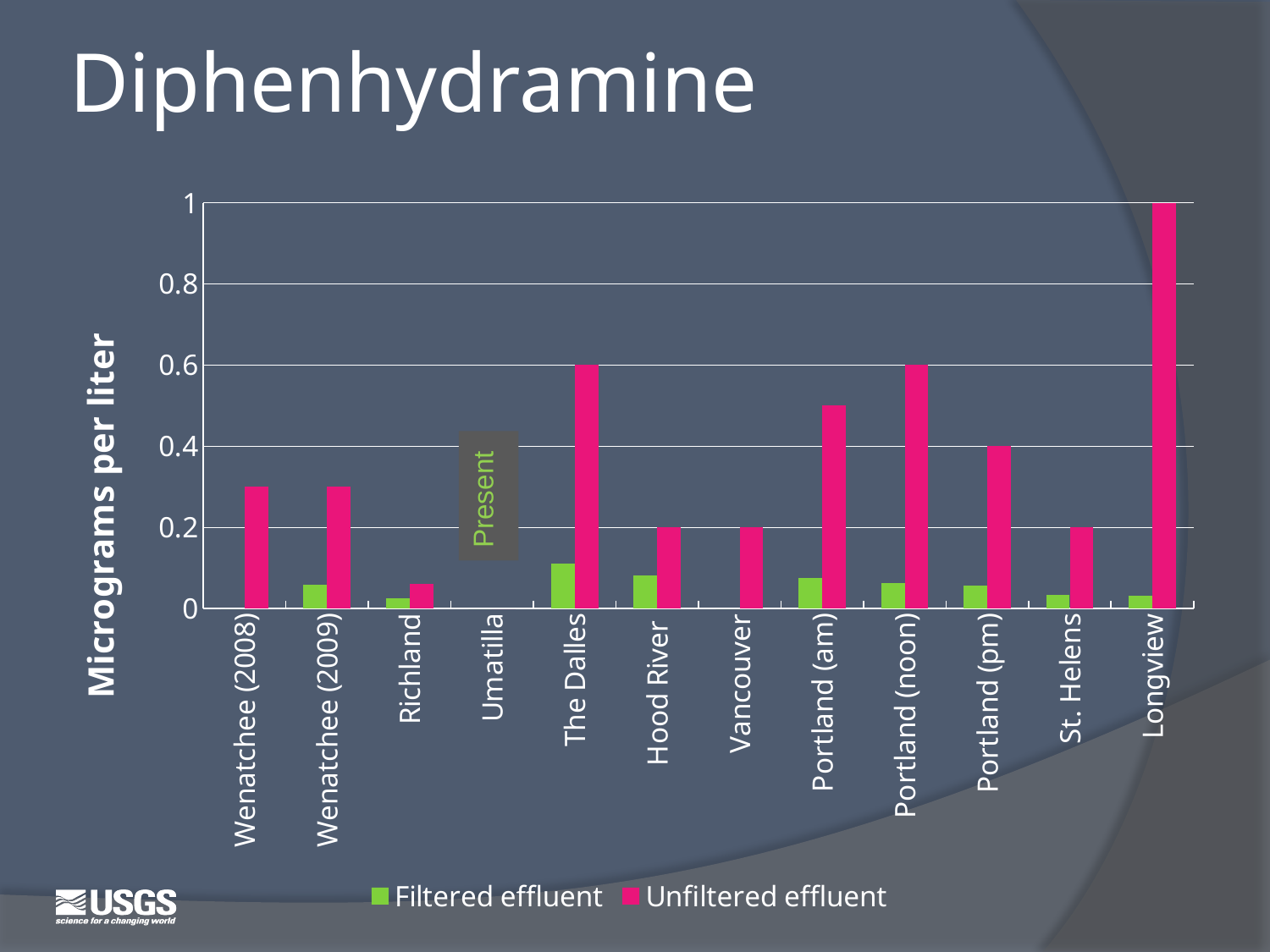
Is the Unfiltered effluent value for Wenatchee (2008) greater or less than 0.4? less Which category has the highest Unfiltered effluent value? Longview Which series is shown in green in the legend? Filtered effluent Which is larger, the Unfiltered effluent value for The Dalles or for Hood River? The Dalles What is the label on the y axis? Micrograms per liter How many categories are shown along the x axis? 12 What kind of chart is shown on the slide? bar chart How many series does the legend list? 2 What is the Unfiltered effluent value for The Dalles? 0.6 What is the Unfiltered effluent value for Portland (pm)? 0.4 Is the Unfiltered effluent value for Portland (am) greater or less than 0.4? greater What is the Unfiltered effluent value for Longview? 1